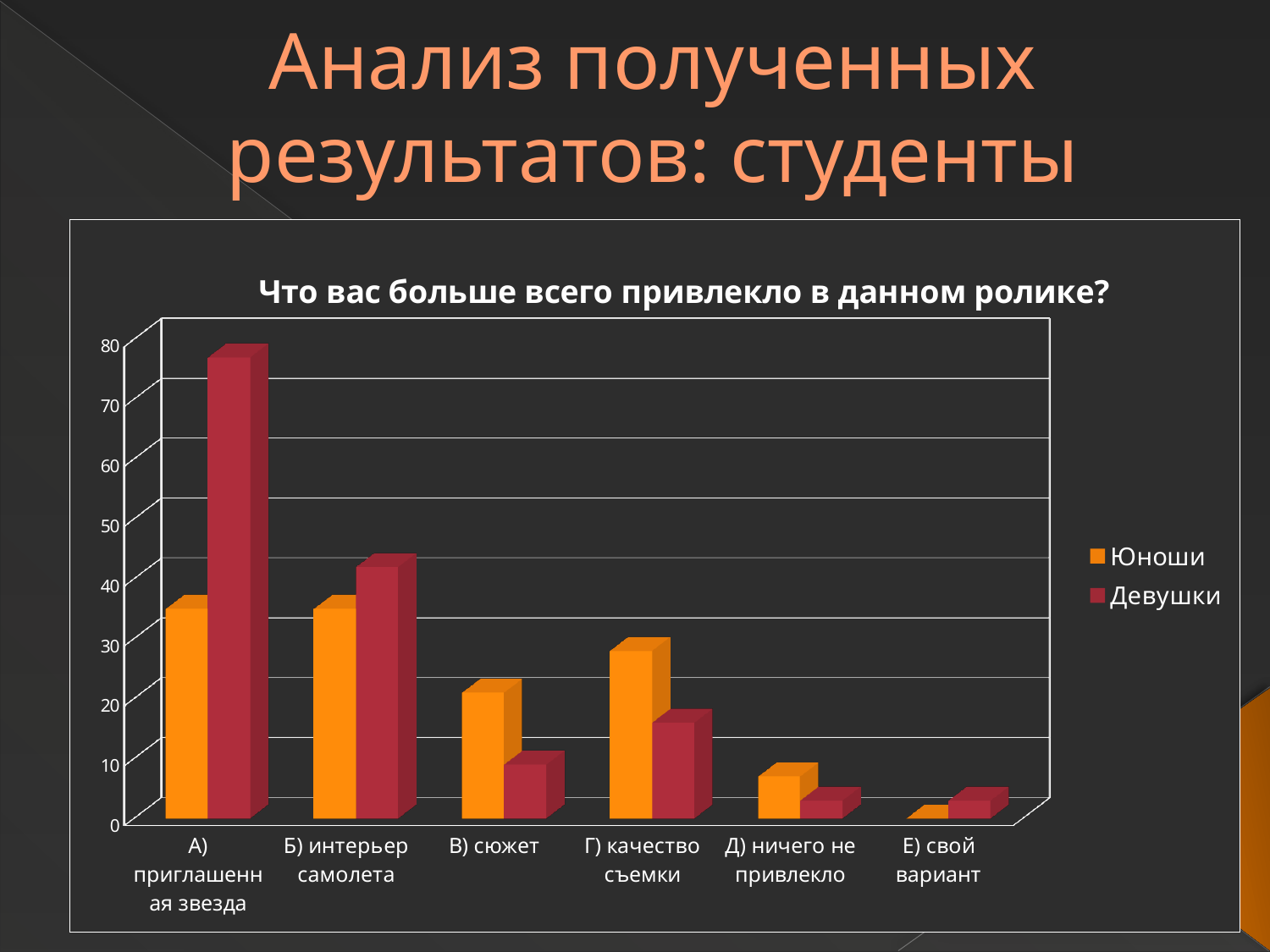
What kind of chart is shown on the slide? bar chart For the Девушки series, which category has the highest value? А) приглашенная звезда How many answer categories are shown along the x axis? 6 Is the Юноши value for Д) ничего не привлекло greater or less than 10? less For the Юноши series, which category has the lowest value? Е) свой вариант What is the title of the chart? Что вас больше всего привлекло в данном ролике? How many series does the legend list? 2 For В) сюжет, which series has the larger value, Юноши or Девушки? Юноши For Г) качество съемки, which series has the larger value, Юноши or Девушки? Юноши Is the Девушки value for А) приглашенная звезда greater or less than 70? greater For А) приглашенная звезда, which series has the larger value, Юноши or Девушки? Девушки Is the Юноши value for Г) качество съемки greater or less than 20? greater